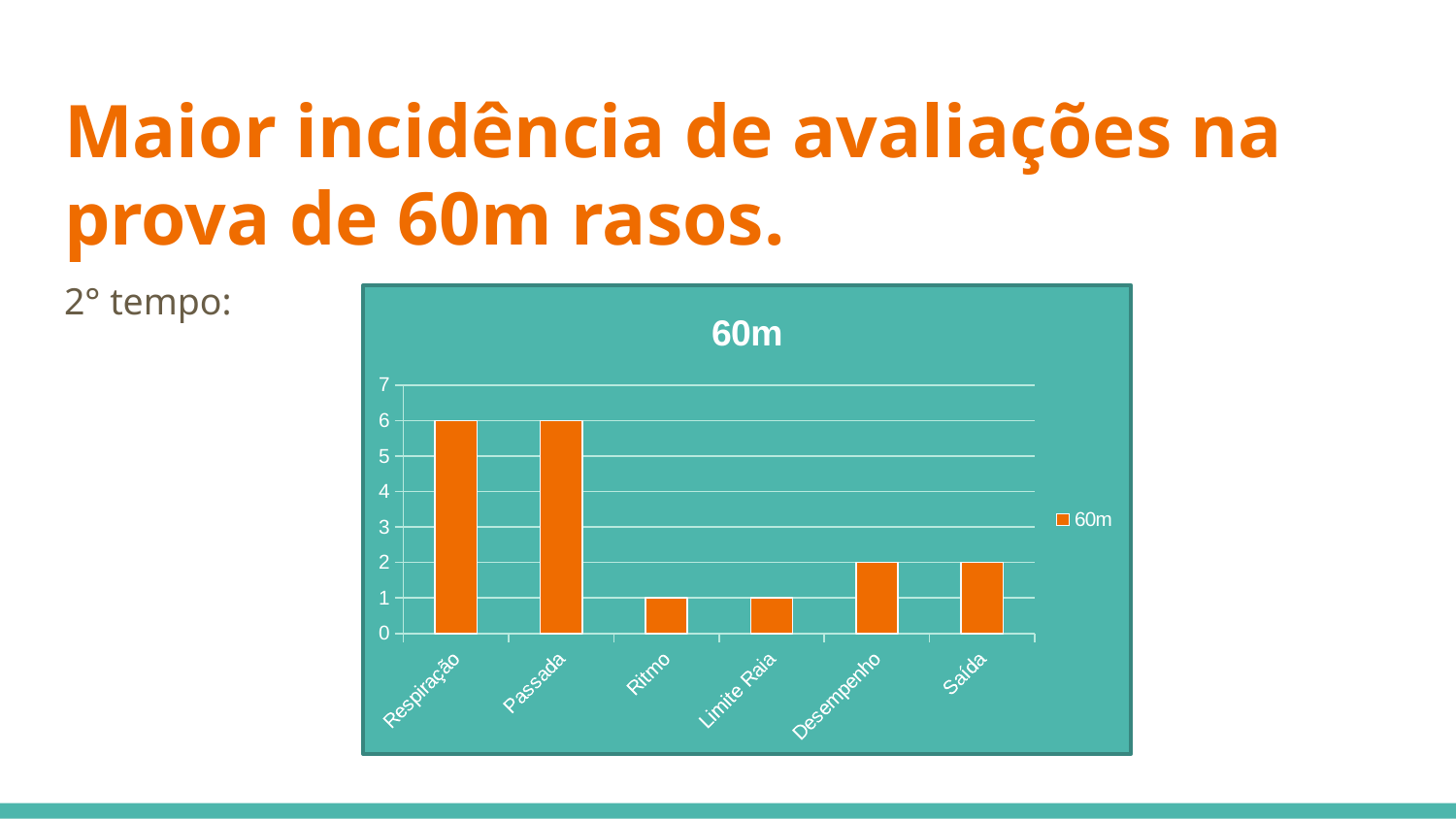
What is the difference between the values for Passada and Saída? 4 Is the value for Limite Raia greater or less than 3? less Which is larger, the value for Respiração or the value for Desempenho? Respiração How many series does the chart legend list? 1 What kind of chart is shown on the slide? bar chart What is the value for Ritmo in the 60m chart? 1 What is the value for Saída in the 60m chart? 2 What is the title of the chart? 60m How many categories are shown on the x axis of the chart? 6 What is the value for Desempenho in the 60m chart? 2 What is the value for Passada in the 60m chart? 6 What is the value for Respiração in the 60m chart? 6